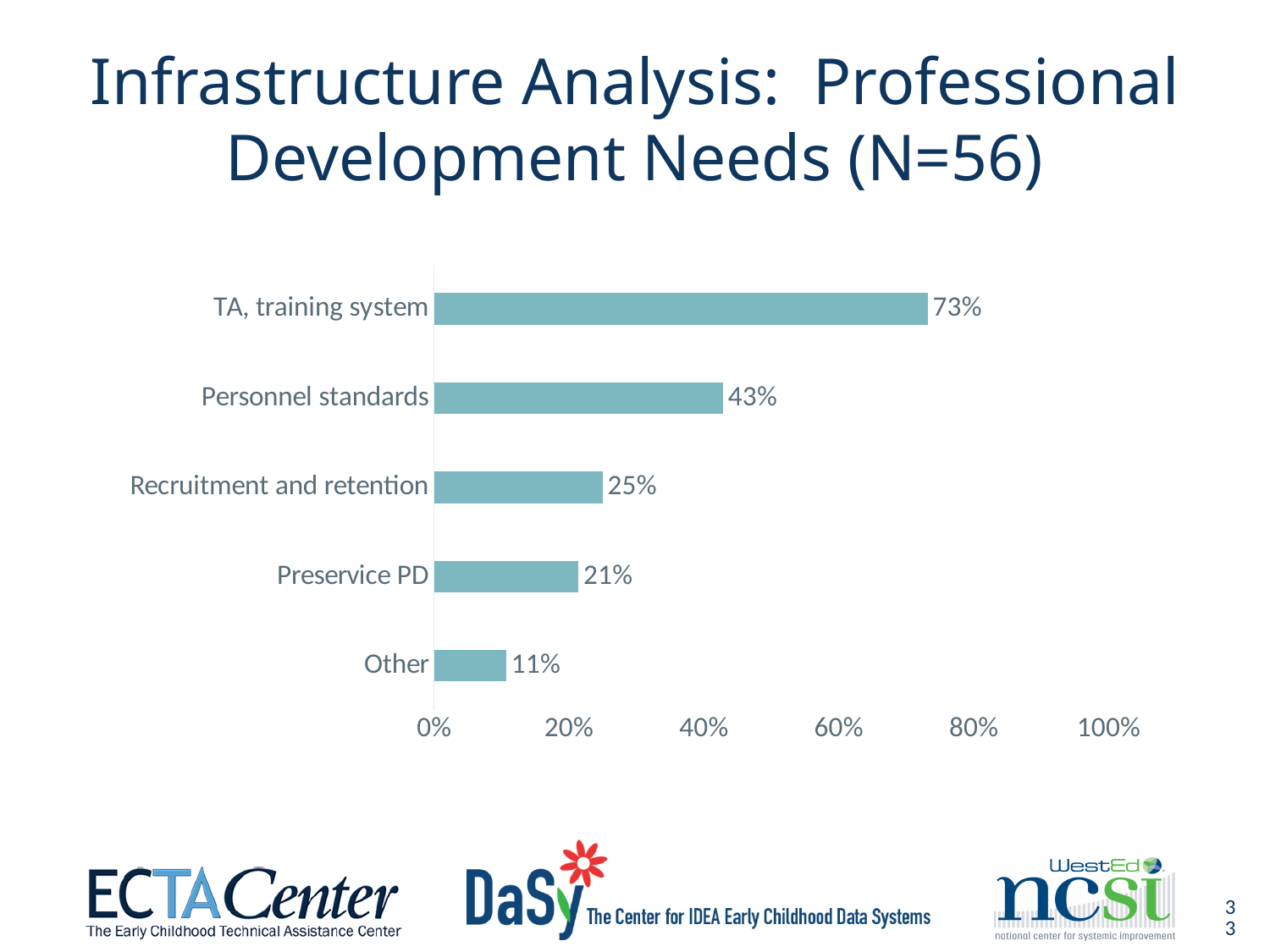
Is the value for Personnel standards greater or less than 40%? greater Which category has the lowest value? Other How many categories are shown in the chart? 5 What is the value for TA, training system? 73% What is the difference between the values for Recruitment and retention and Preservice PD? 4% What is the value for Recruitment and retention? 25% What kind of chart is shown on the slide? bar chart Which is larger, the value for Personnel standards or the value for Recruitment and retention? Personnel standards What is the value for Preservice PD? 21% Which category has the highest value? TA, training system What is the difference between the values for TA, training system and Personnel standards? 30% What is the value for Personnel standards? 43%